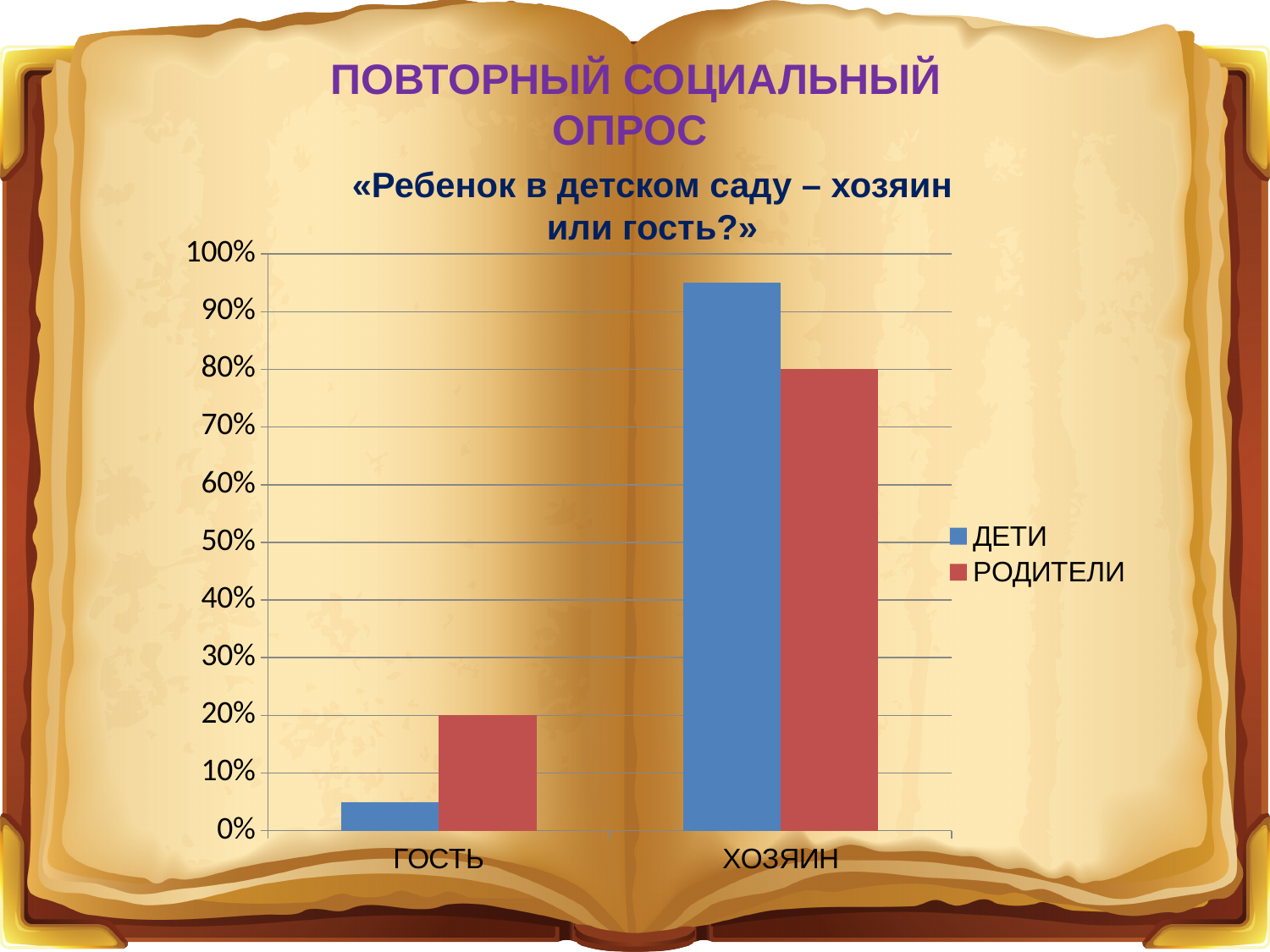
In the ГОСТЬ category, which series has the larger value, ДЕТИ or РОДИТЕЛИ? РОДИТЕЛИ Which category has the higher value for ДЕТИ, ГОСТЬ or ХОЗЯИН? ХОЗЯИН Which colour represents the ДЕТИ series in the legend? blue What is the value for РОДИТЕЛИ in the ГОСТЬ category? 20% How many categories are shown on the x axis? 2 Is the value for ДЕТИ in the ХОЗЯИН category greater or less than 90%? greater What is the difference between the РОДИТЕЛИ values for ХОЗЯИН and ГОСТЬ? 60% Is the value for ДЕТИ in the ГОСТЬ category greater or less than 10%? less In the ХОЗЯИН category, which series has the larger value, ДЕТИ or РОДИТЕЛИ? ДЕТИ How many series does the legend list? 2 What is the value for РОДИТЕЛИ in the ХОЗЯИН category? 80% What kind of chart is shown on the slide? bar chart